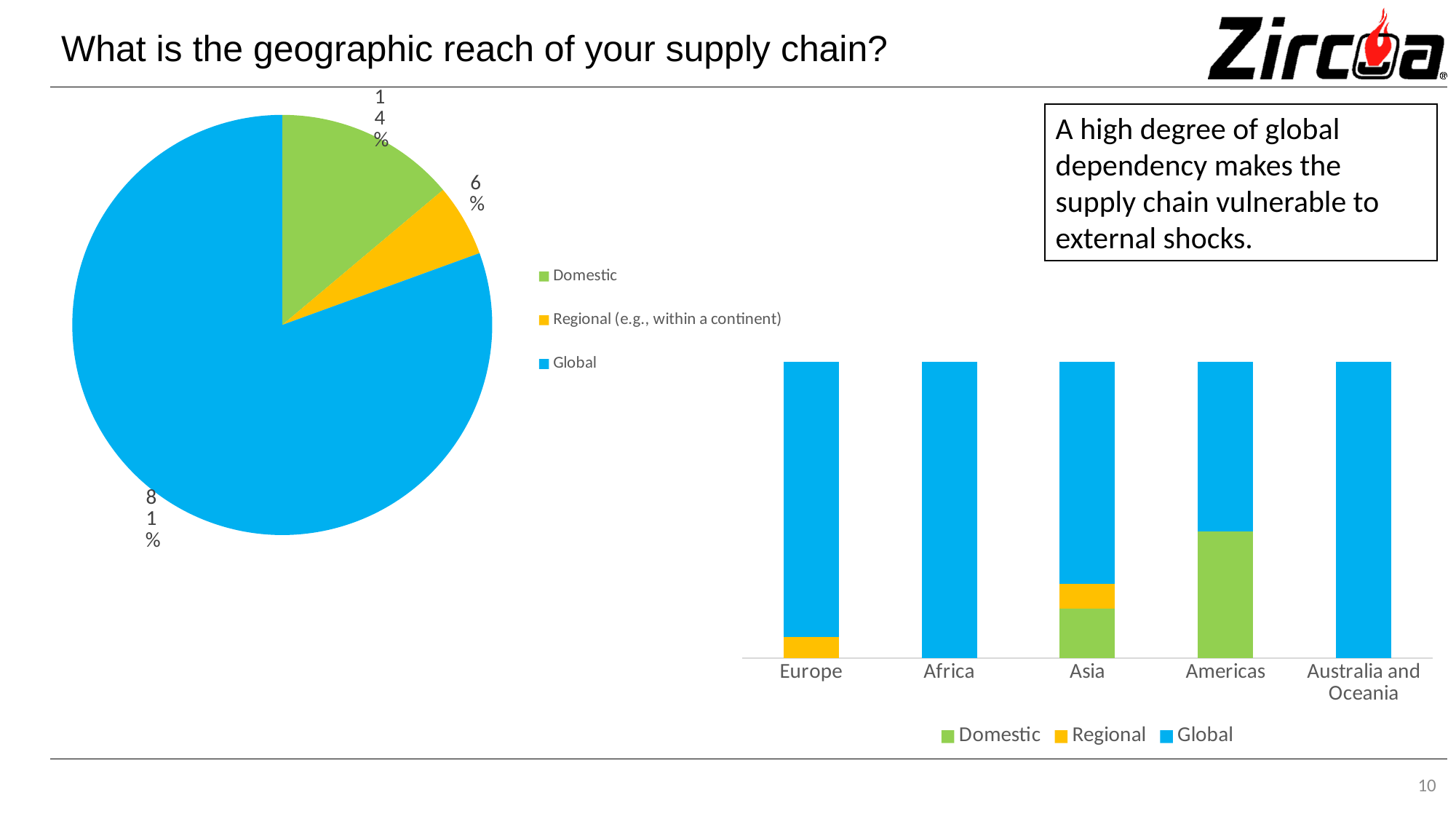
In the pie chart on the left, what percentage is shown for Domestic? 14% In the pie chart on the left, what is the difference in percentage points between the Domestic and Regional shares? 8 In the bar chart on the right, how many regions are shown on the x axis? 5 In the pie chart on the left, which category has the largest share? Global In the bar chart on the right, which region has a Regional segment but no Domestic segment? Europe In the pie chart on the left, which category has the smallest share? Regional (e.g., within a continent) In the pie chart on the left, what percentage is shown for Global? 81% What type of chart is the chart on the right of the slide? Stacked bar chart In the bar chart on the right, which region has the largest Domestic segment? Americas In the pie chart on the left, what percentage is shown for Regional (e.g., within a continent)? 6% In the bar chart on the right, how many series does the legend list? 3 In the pie chart on the left, how many slices are there? 3